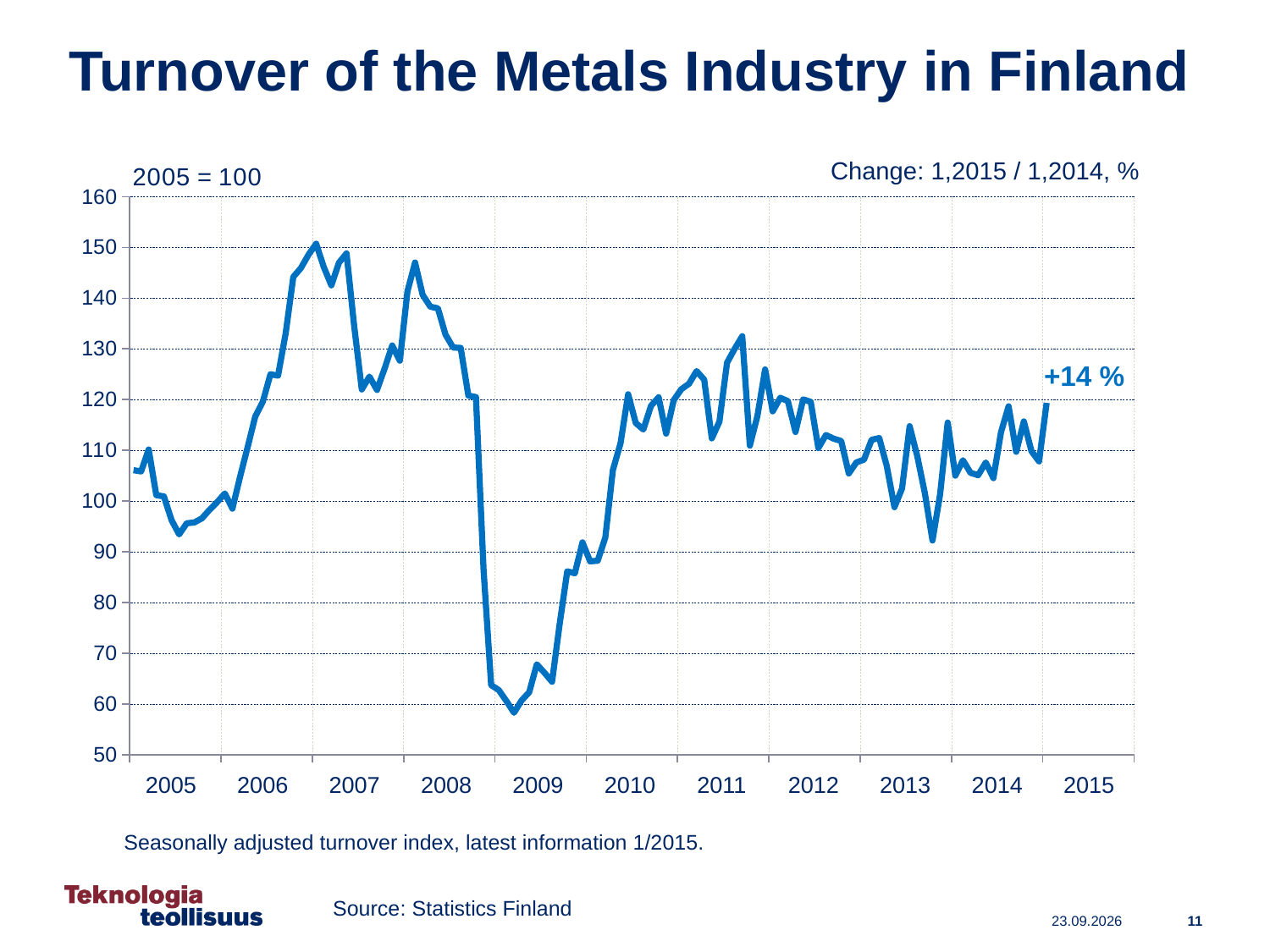
What is the change from 1/2014 to 1/2015 shown on the chart? +14 % How many year labels are shown on the x axis? 11 What is the title of the chart on the slide? Turnover of the Metals Industry in Finland In which year does the index reach its lowest point? 2009 What base year and value is the index set to, as noted above the chart? 2005 = 100 Is the lowest value of the index in 2009 greater or less than 70? less Is the index value at the start of 2013 greater or less than 100? greater Is the peak value of the index in 2006 greater or less than 140? greater Does the index rise or fall between the end of 2008 and the start of 2009? Fall How many data series are plotted on the chart? 1 What kind of chart is shown on the slide? Line chart Which is larger, the index value at the start of 2010 or at the start of 2009? Start of 2010